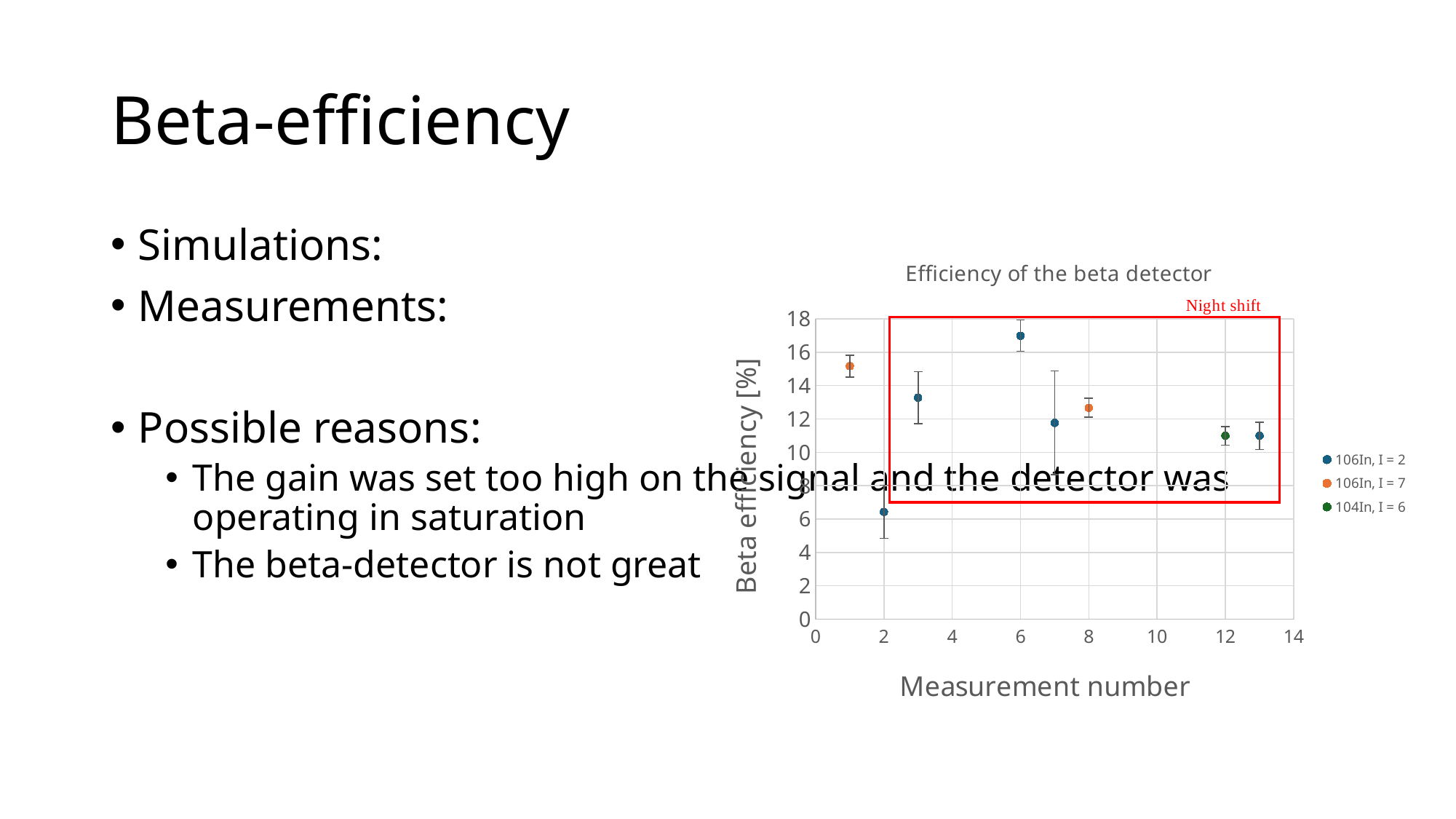
Is the beta efficiency for measurement number 2 greater or less than 8? less Is the beta efficiency for measurement number 8 greater or less than 14? less How many data points are plotted in the chart? 8 Which has a higher beta efficiency, measurement number 1 or measurement number 2? Measurement number 1 Is the beta efficiency for measurement number 1 greater or less than 14? greater What label is written above the red box drawn on the chart? Night shift How many series does the chart legend list? 3 Which measurement number has the highest beta efficiency? 6 Which measurement number has the lowest beta efficiency? 2 What kind of chart is shown on the slide? Scatter chart What is the title of the chart? Efficiency of the beta detector